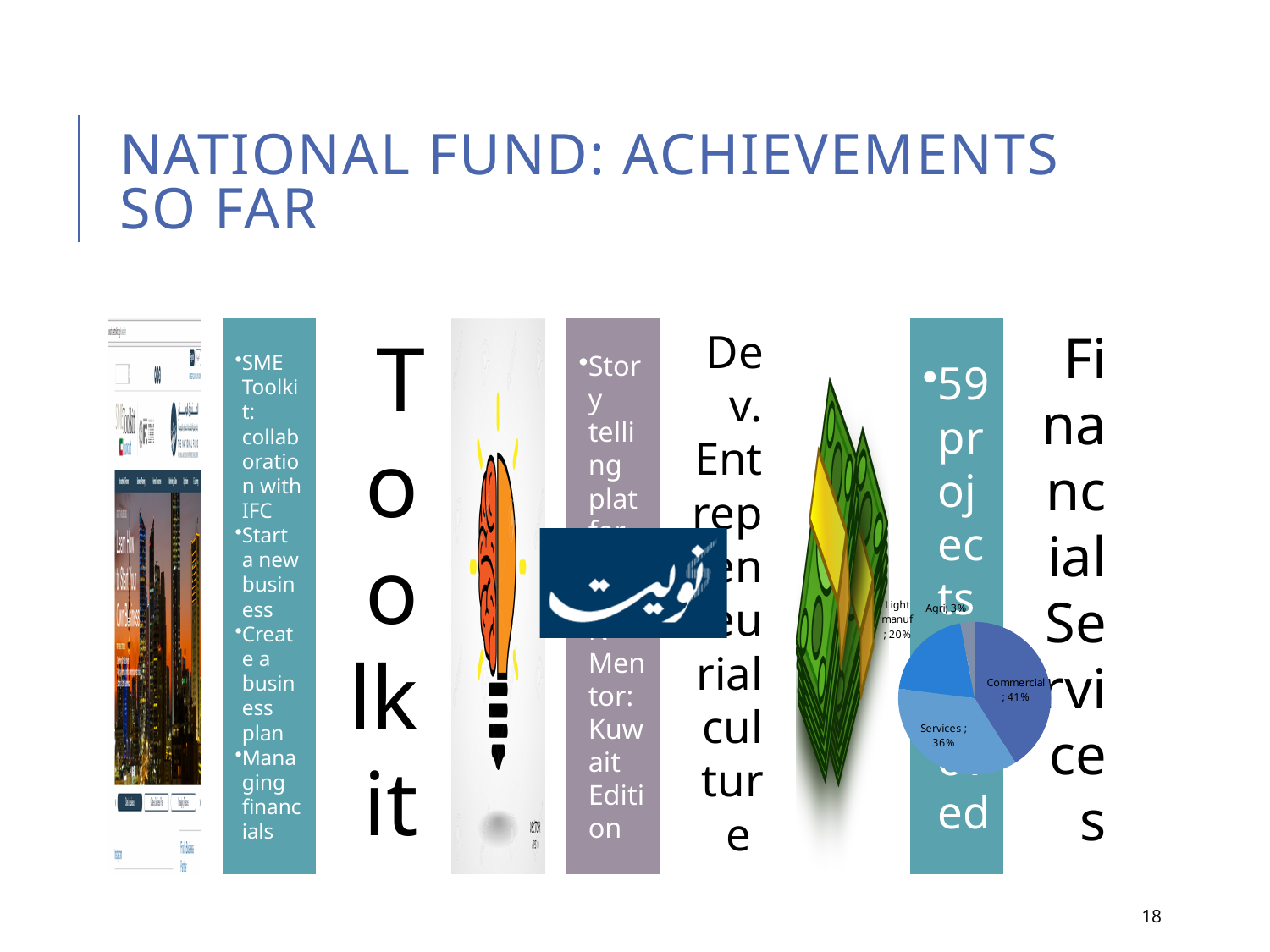
How many slices does the pie chart have? 4 What share of the pie chart is Services? 36% What share of the pie chart is Commercial? 41% What share of the pie chart is Light manuf? 20% Which slice is larger, Light manuf or Services? Services What kind of chart is shown on the slide? pie chart What is the difference in percentage points between the Commercial and Services slices? 5 Which category has the smallest slice of the pie chart? Agri Which category has the largest slice of the pie chart? Commercial What share of the pie chart is Agri? 3% What is the difference in percentage points between the Light manuf and Agri slices? 17